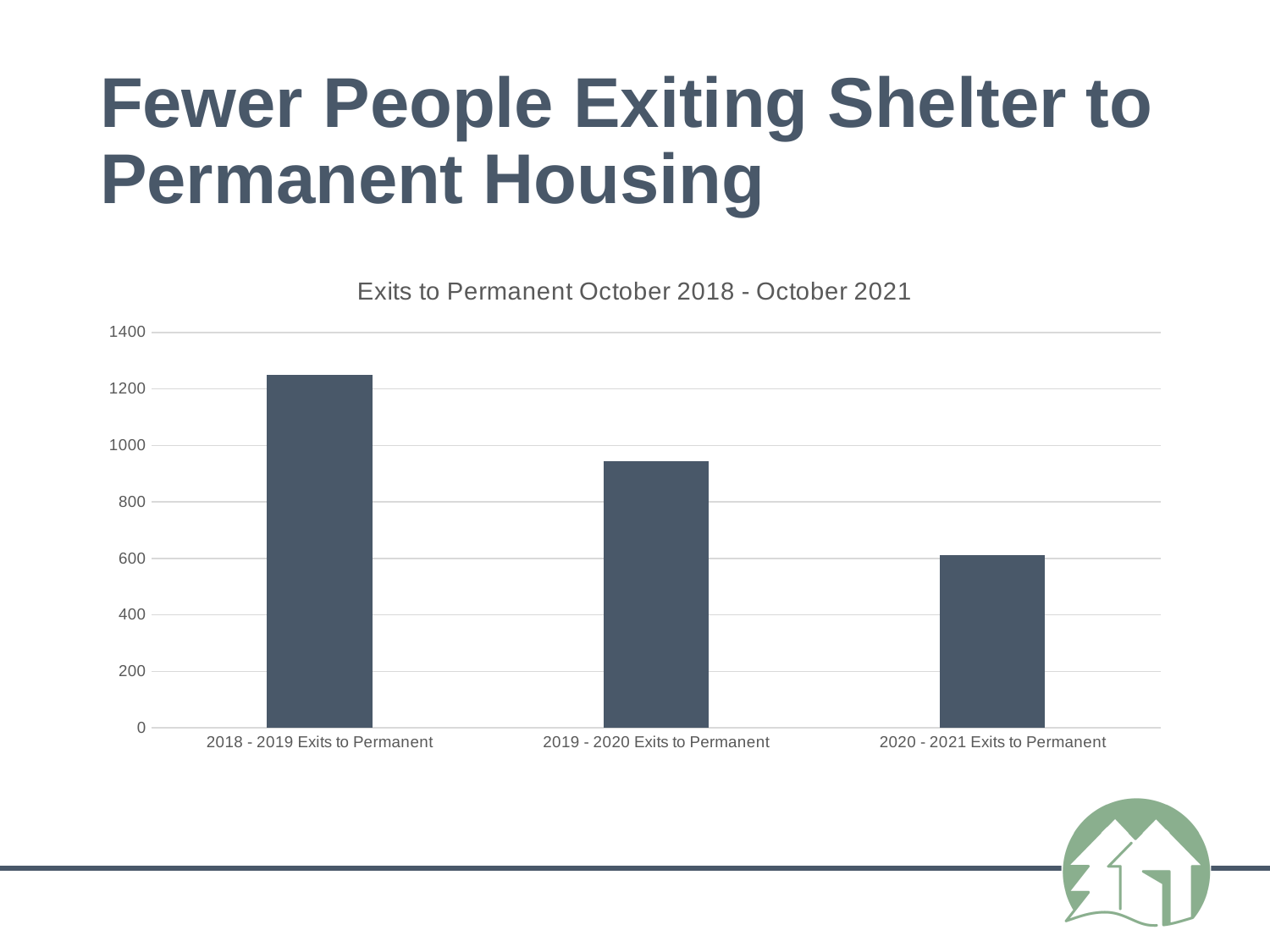
Which category has the highest value? 2018 - 2019 Exits to Permanent Do the values rise or fall from left to right across the x axis? fall Which category has the lowest value? 2020 - 2021 Exits to Permanent What kind of chart is shown on the slide? bar chart How many categories are plotted in the chart? 3 Is the value for 2019 - 2020 Exits to Permanent greater or less than 1000? less Which is larger, the value for 2019 - 2020 Exits to Permanent or 2020 - 2021 Exits to Permanent? 2019 - 2020 Exits to Permanent Is the value for 2019 - 2020 Exits to Permanent greater or less than 800? greater What is the title of the chart? Exits to Permanent October 2018 - October 2021 Which is larger, the value for 2018 - 2019 Exits to Permanent or 2019 - 2020 Exits to Permanent? 2018 - 2019 Exits to Permanent Is the value for 2020 - 2021 Exits to Permanent greater or less than 800? less